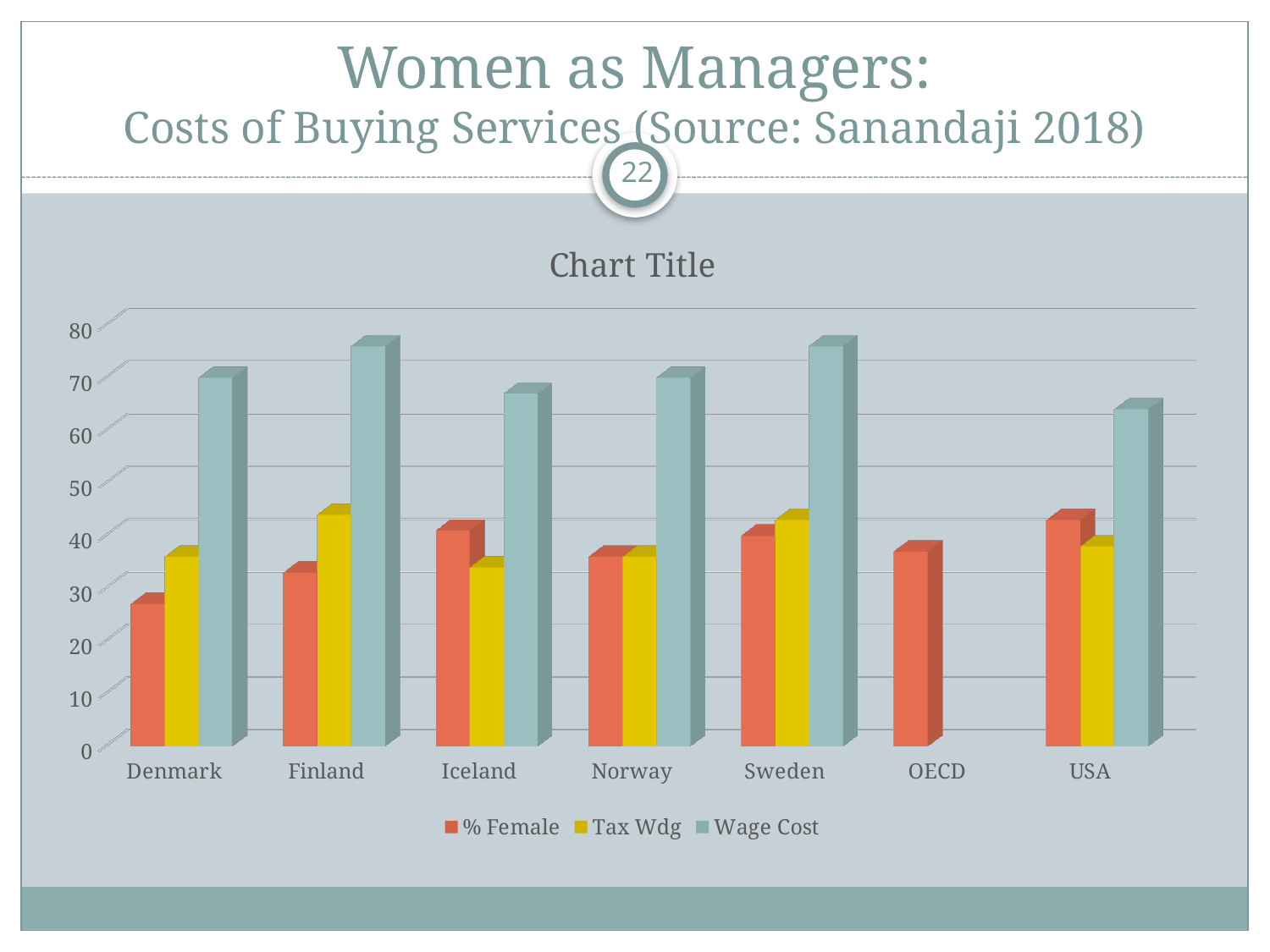
Which category has bars for only one series? OECD Is the Wage Cost value for Denmark greater or less than 60? greater Is the Wage Cost value for Finland greater or less than 70? greater Which category has the lowest % Female value? Denmark How many series does the legend list? 3 For Denmark, which is larger: % Female or Tax Wdg? Tax Wdg How many categories are shown on the x axis? 7 Is the % Female value for OECD greater or less than 40? less Which is larger: the Wage Cost for Finland or the Wage Cost for Iceland? Finland What kind of chart is shown on the slide? bar chart